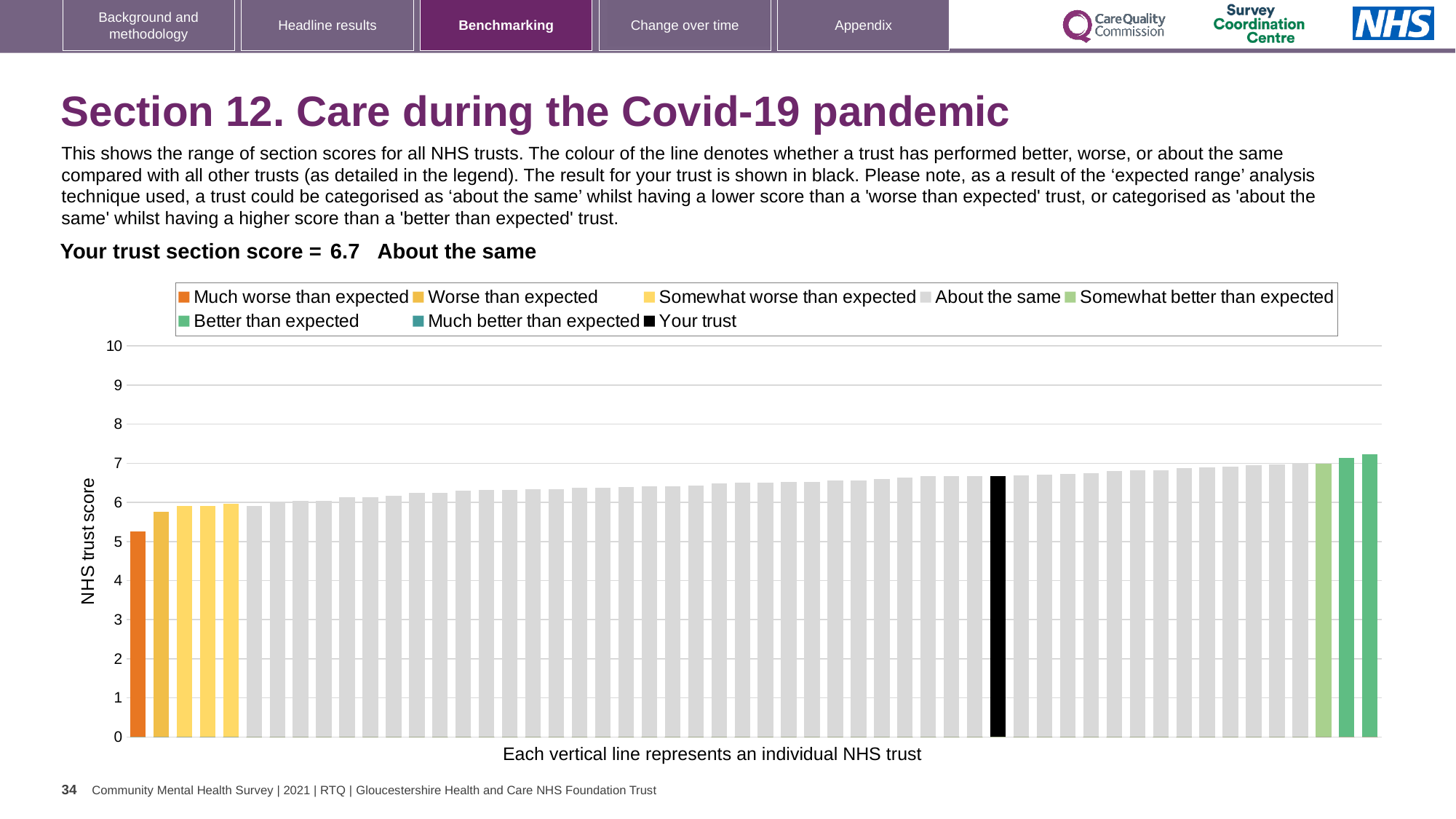
Which performance category is your trust placed in for this section? About the same What is the label on the vertical axis of the chart? NHS trust score How many bars are coloured orange (Much worse than expected)? 1 Is the bar for your trust higher or lower than the orange 'Much worse than expected' bar? higher Do the bar values rise or fall from left to right along the x axis? rise What is the section score for your trust? 6.7 Is the value of the tallest bar greater or less than 7? greater How many entries does the chart legend list? 8 What colour is the bar representing your trust? black Is the value for your trust (the black bar) greater or less than 6? greater What kind of chart is shown on the slide? bar chart Is the value of the lowest bar (the orange bar) greater or less than 6? less